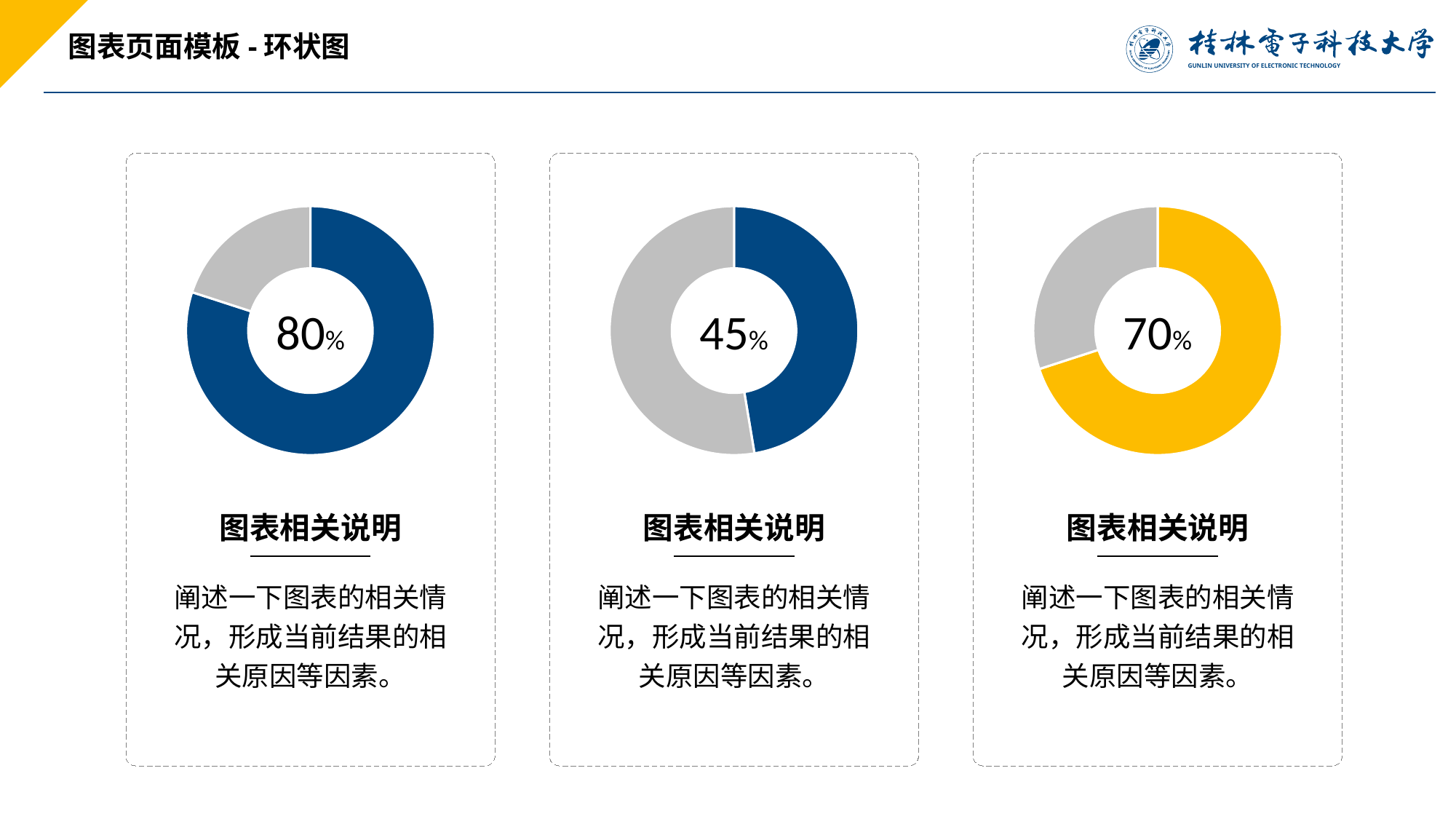
What percentage is shown in the centre of the right donut chart? 70% Is the value in the middle donut chart greater or less than 50%? less Which of the three donut charts shows the lowest percentage? The middle chart (45%) What is the difference between the percentage in the left donut chart and the percentage in the middle donut chart? 35% What is the difference between the percentage in the right donut chart and the percentage in the middle donut chart? 25% What percentage is shown in the centre of the left donut chart? 80% How many donut charts are on the slide? 3 What colour is the filled portion of the right donut chart? Yellow Is the percentage in the left donut chart larger or smaller than the percentage in the right donut chart? Larger Which of the three donut charts shows the highest percentage? The left chart (80%) What kind of chart is used on this slide? Donut chart What percentage is shown in the centre of the middle donut chart? 45%